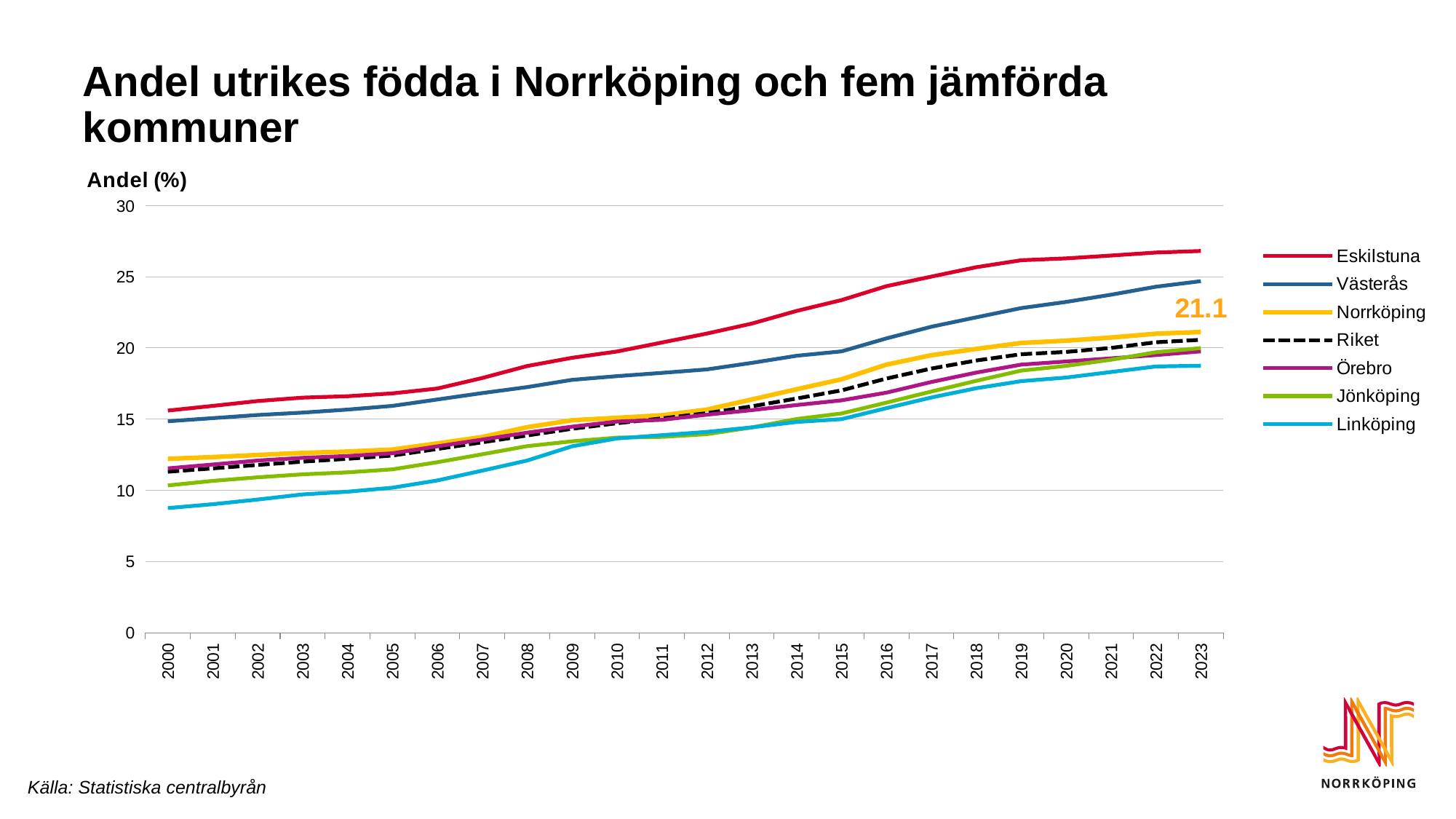
Is the value for Eskilstuna in 2023 greater or less than 25? greater How many series does the legend list? 7 Does the Eskilstuna line rise or fall from 2000 to 2023? rise What is the value for Norrköping in 2023? 21.1 Which municipality has the highest share in 2023? Eskilstuna In 2023, which is larger, the value for Västerås or the value for Norrköping? Västerås Is the value for Linköping in 2000 greater or less than 10? less Which series has the lowest share in 2023? Linköping Which series has the lowest share in 2000? Linköping What kind of chart is shown on the slide? line chart Which series is drawn as a dashed line? Riket How many years are shown on the x axis? 24